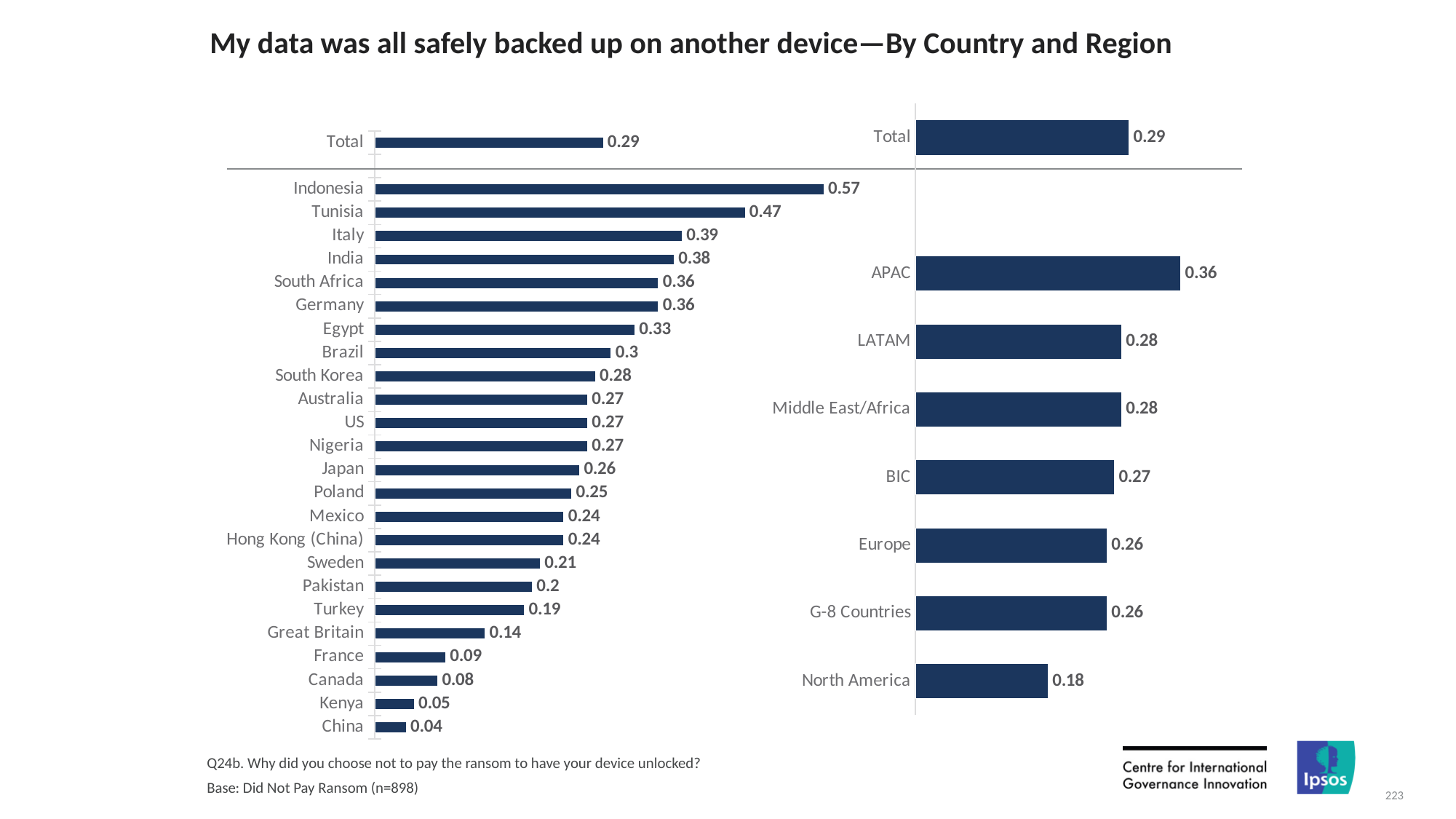
What is the value for Total shown in both charts? 0.29 In the left chart (by country), what is the difference between the values for Tunisia and Italy? 0.08 What kind of chart is the left chart (by country)? Bar chart In the right chart (by region), how many regions are shown below the Total bar? 7 In the right chart (by region), which region has the highest value? APAC In the left chart (by country), which is larger, the value for Egypt or the value for Brazil? Egypt In the left chart (by country), which country has the highest value? Indonesia In the left chart (by country), what is the value for Indonesia? 0.57 In the right chart (by region), what is the difference between the values for APAC and North America? 0.18 In the left chart (by country), what is the value for Great Britain? 0.14 In the right chart (by region), what is the value for North America? 0.18 In the left chart (by country), which country has the lowest value? China